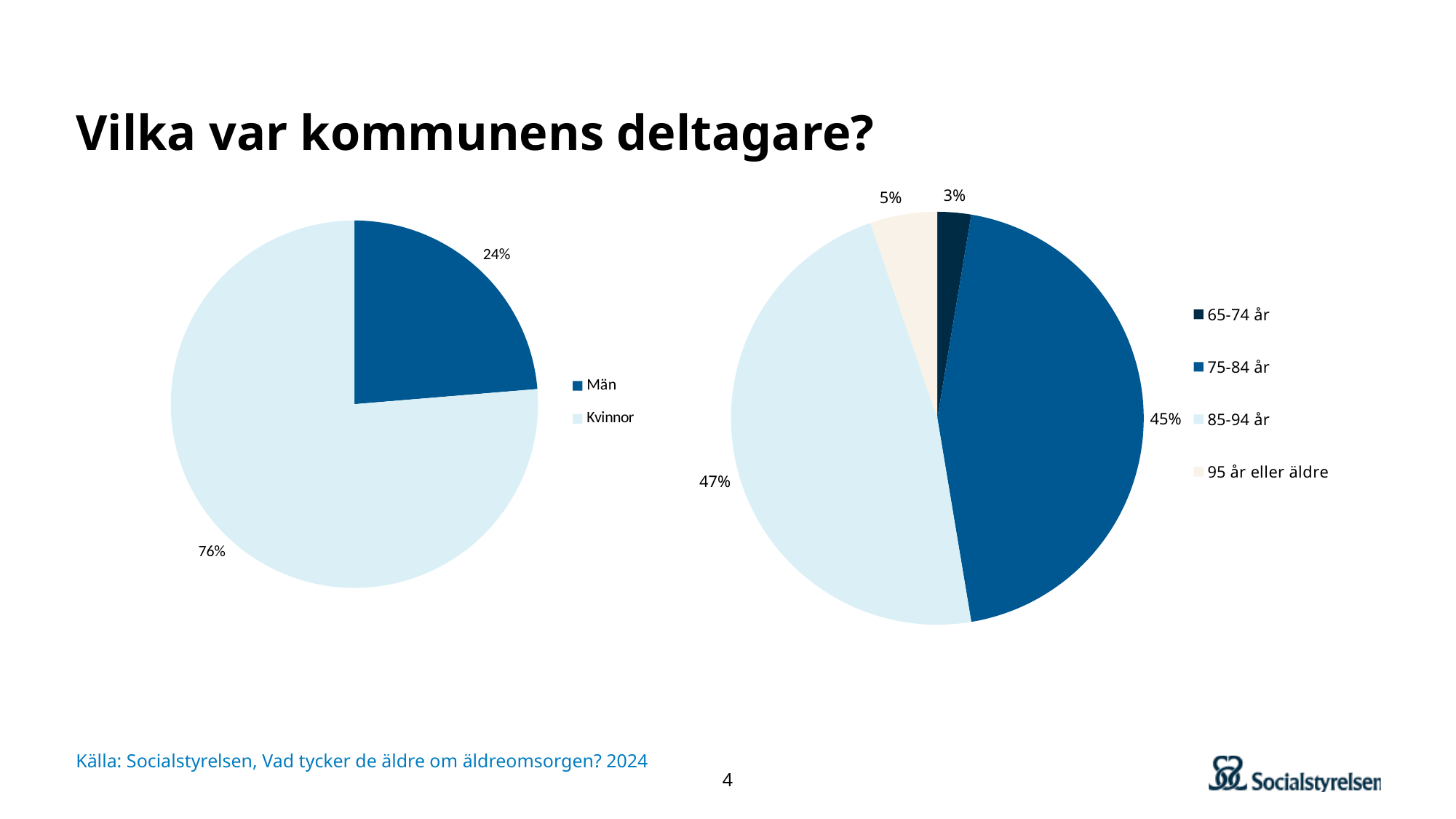
In the right pie chart, which age group has the smallest share? 65-74 år In the left pie chart, what share of participants are Män? 24% In the right pie chart, what is the difference in percentage points between 85-94 år and 65-74 år? 44 In the right pie chart, what share of participants are 75-84 år? 45% In the right pie chart, which age group has the largest share? 85-94 år What kind of chart is the left chart on the slide? Pie chart How many age groups does the legend of the right pie chart list? 4 In the left pie chart, which category has the larger share, Män or Kvinnor? Kvinnor How many categories does the legend of the left pie chart list? 2 In the left pie chart, what share of participants are Kvinnor? 76% In the left pie chart, what is the difference in percentage points between Kvinnor and Män? 52 In the right pie chart, what share of participants are 95 år eller äldre? 5%